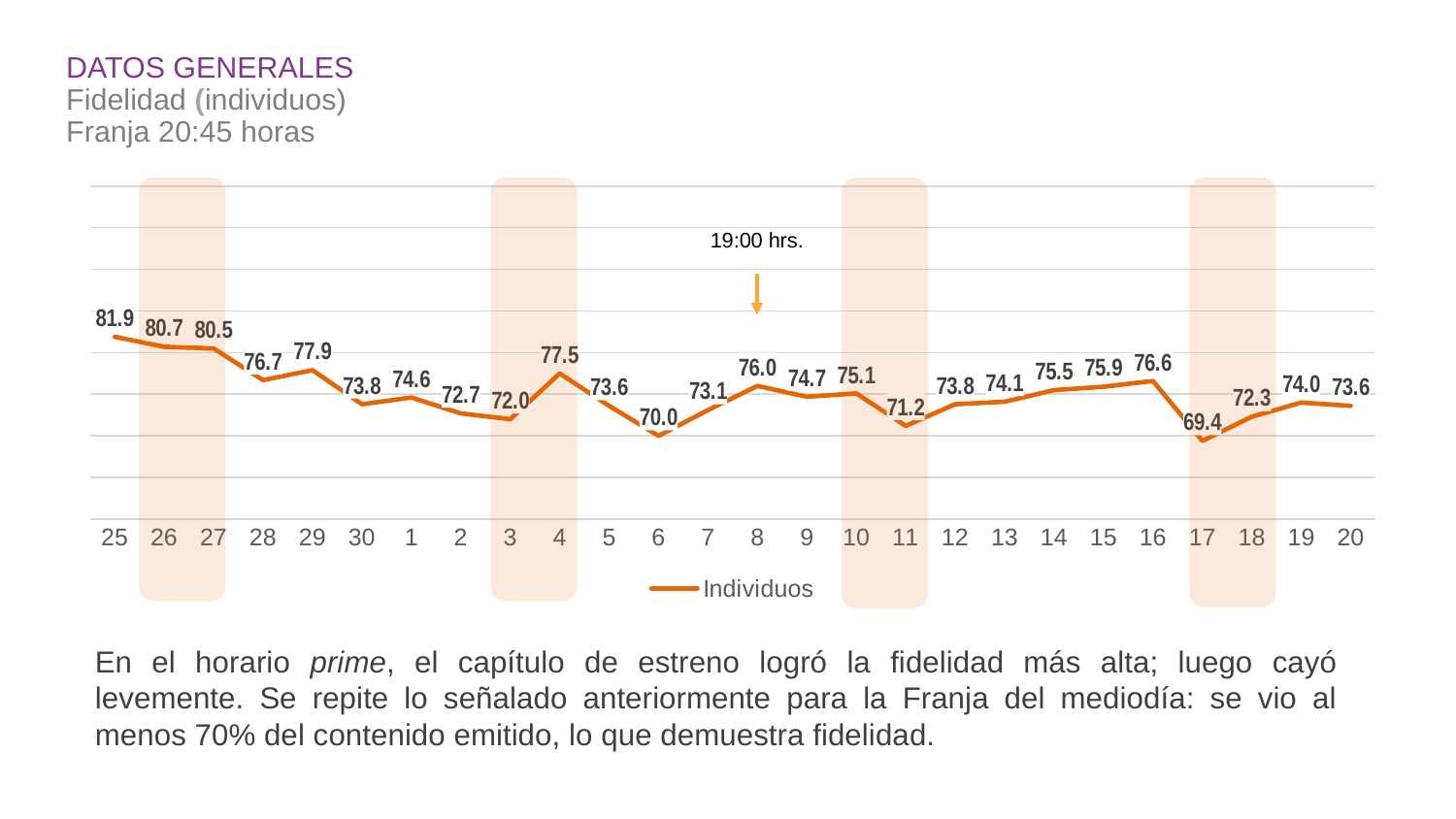
What kind of chart is shown on the slide? line chart Which category has the highest value? 25 Which category has the lowest value? 17 What is the value for category 25? 81.9 Which is larger, the value for category 16 or the value for category 18? 16 What is the difference between the values for category 6 and category 8? 6.0 What is the value for category 17? 69.4 What is the name of the series shown in the legend? Individuos How many data points are plotted on the chart? 26 What is the value for category 4? 77.5 How many series does the legend list? 1 What is the difference between the values for category 25 and category 27? 1.4